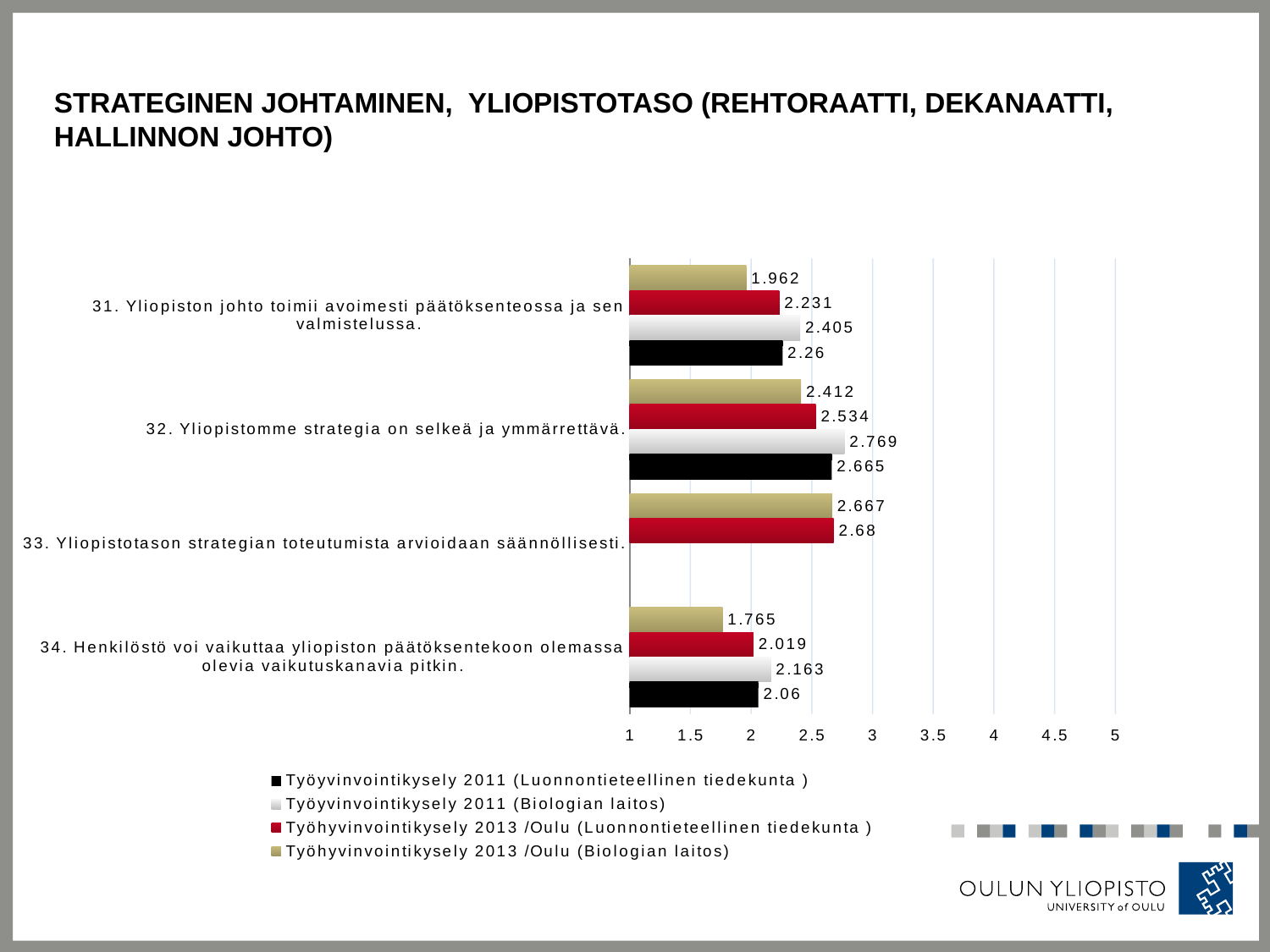
What is the value for Työyvinvointikysely 2011 (Luonnontieteellinen tiedekunta) for statement 34? 2.06 What is the value for Työhyvinvointikysely 2013 /Oulu (Luonnontieteellinen tiedekunta) for statement 33? 2.68 For statement 34, which is larger: the Työhyvinvointikysely 2013 /Oulu (Luonnontieteellinen tiedekunta) value or the Työhyvinvointikysely 2013 /Oulu (Biologian laitos) value? Työhyvinvointikysely 2013 /Oulu (Luonnontieteellinen tiedekunta) How many categories (statements) are shown on the chart? 4 Is the value for Työyvinvointikysely 2011 (Biologian laitos) for statement 32 greater or less than 2.5? greater What is the value for Työyvinvointikysely 2011 (Biologian laitos) for statement 32? 2.769 What is the value for Työhyvinvointikysely 2013 /Oulu (Biologian laitos) for statement 31? 1.962 What kind of chart is shown on the slide? bar chart What is the difference between the Työyvinvointikysely 2011 (Biologian laitos) value and the Työhyvinvointikysely 2013 /Oulu (Biologian laitos) value for statement 32? 0.357 How many series does the legend list? 4 Which series has the highest value for statement 31? Työyvinvointikysely 2011 (Biologian laitos) Which series has the lowest value for statement 34? Työhyvinvointikysely 2013 /Oulu (Biologian laitos)